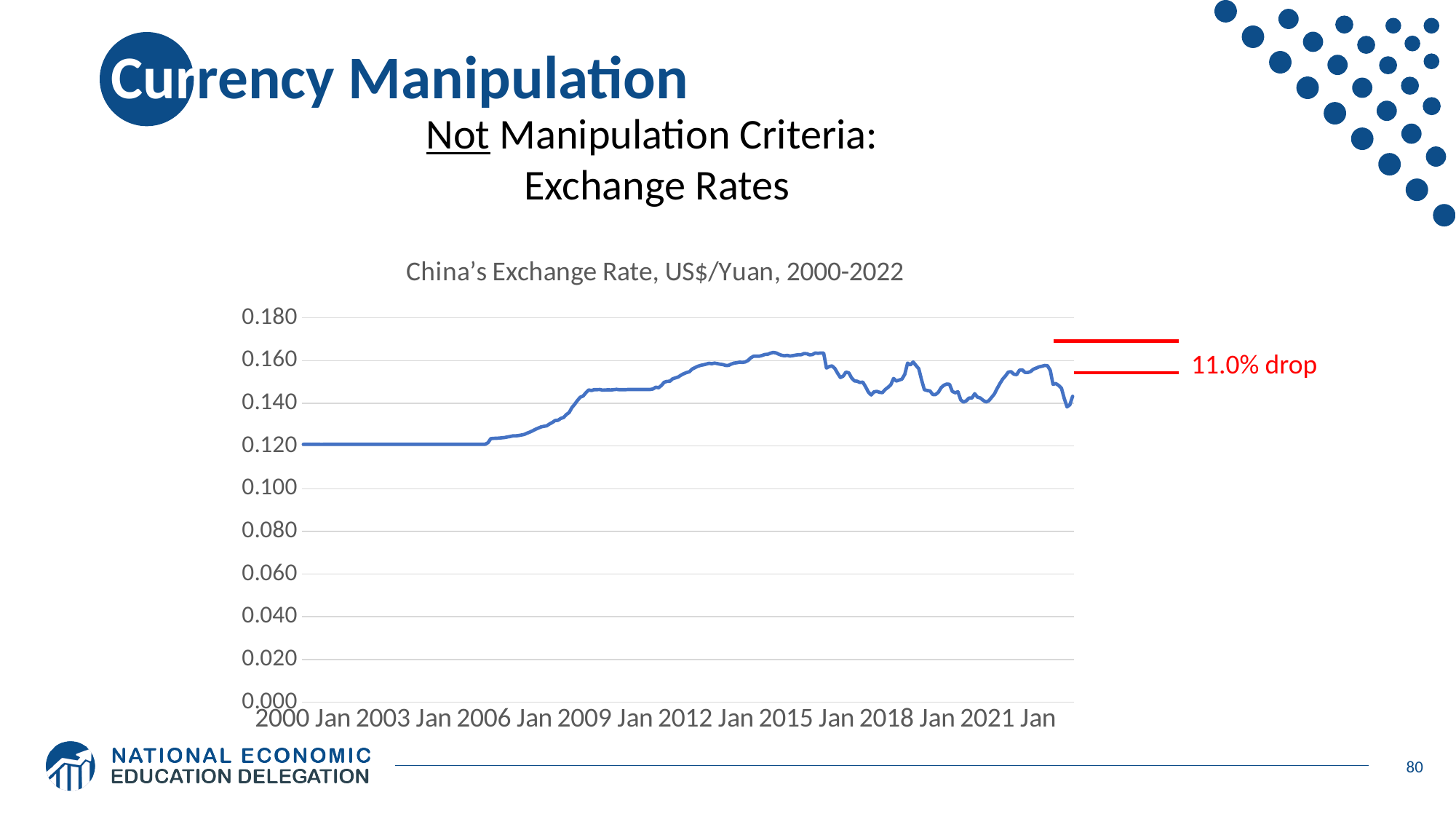
Is the value at 2012 Jan larger or smaller than the value at 2000 Jan? larger Does the exchange rate rise or fall between 2015 Jan and the end of the series? fall What percentage drop is annotated in red on the chart? 11.0% drop Is the exchange rate value at 2003 Jan greater or less than 0.140? less What kind of chart is shown on the slide? line chart Does the exchange rate rise or fall between 2006 Jan and 2012 Jan? rise Is the exchange rate value at 2000 Jan greater or less than 0.100? greater How many year labels are shown on the x axis? 8 Is the exchange rate value at 2012 Jan greater or less than 0.140? greater What is the title of the chart? China's Exchange Rate, US$/Yuan, 2000-2022 What is the highest value shown on the y axis? 0.180